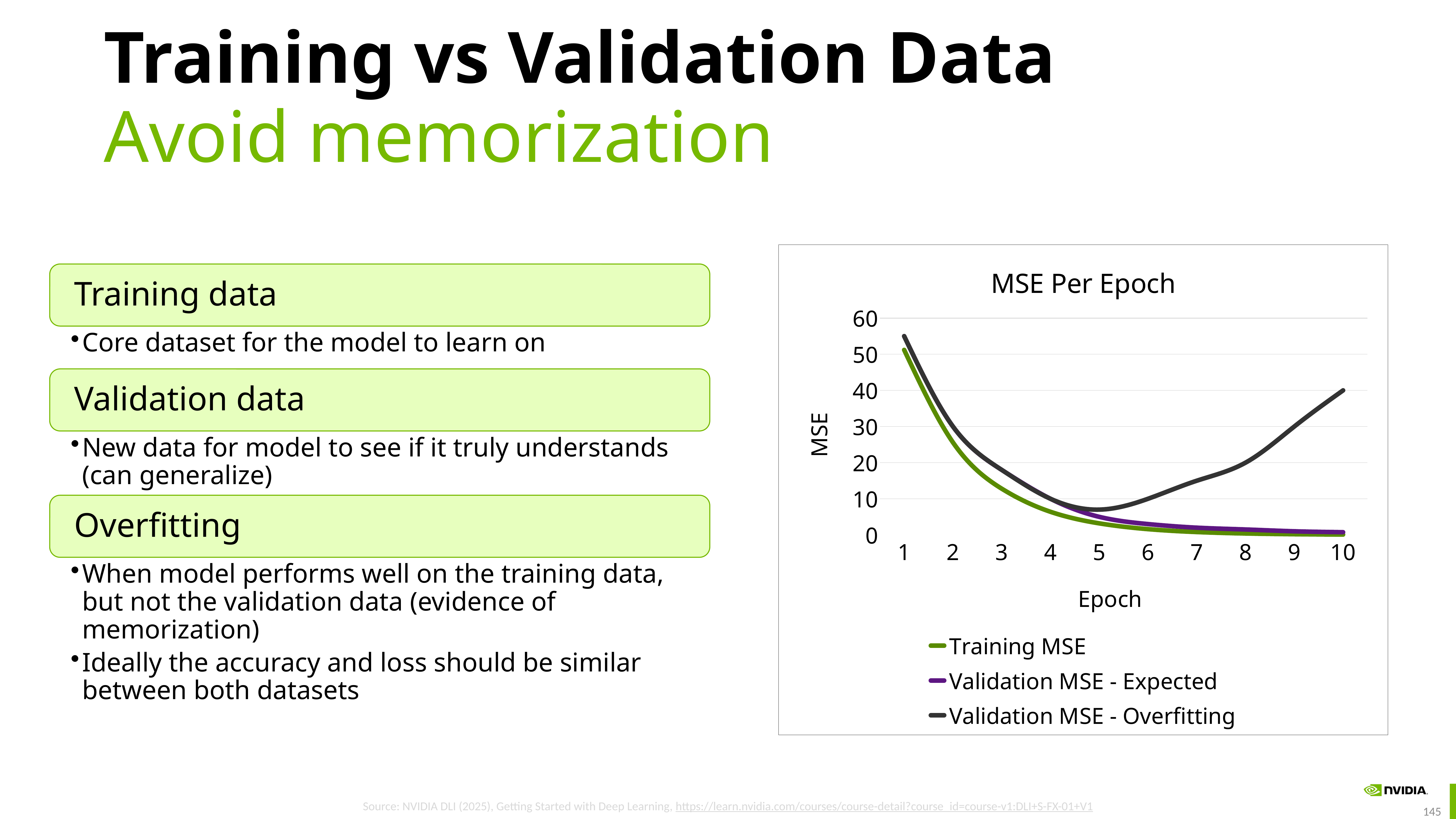
Is the Training MSE value at epoch 10 greater or less than 10? less Does the Validation MSE - Overfitting series rise or fall between epoch 5 and epoch 10? rise How many epochs are plotted along the x axis of the chart? 10 Does the Training MSE series rise or fall as the epoch increases from 1 to 10? fall Is the Validation MSE - Overfitting value at epoch 7 greater or less than 10? greater How many series does the chart legend list? 3 Is the Validation MSE - Overfitting value at epoch 1 greater or less than 50? greater At epoch 10, which series has the higher MSE: Training MSE or Validation MSE - Overfitting? Validation MSE - Overfitting What is the title of the chart? MSE Per Epoch Which series is drawn in green in the chart? Training MSE What kind of chart is shown on the slide? line chart